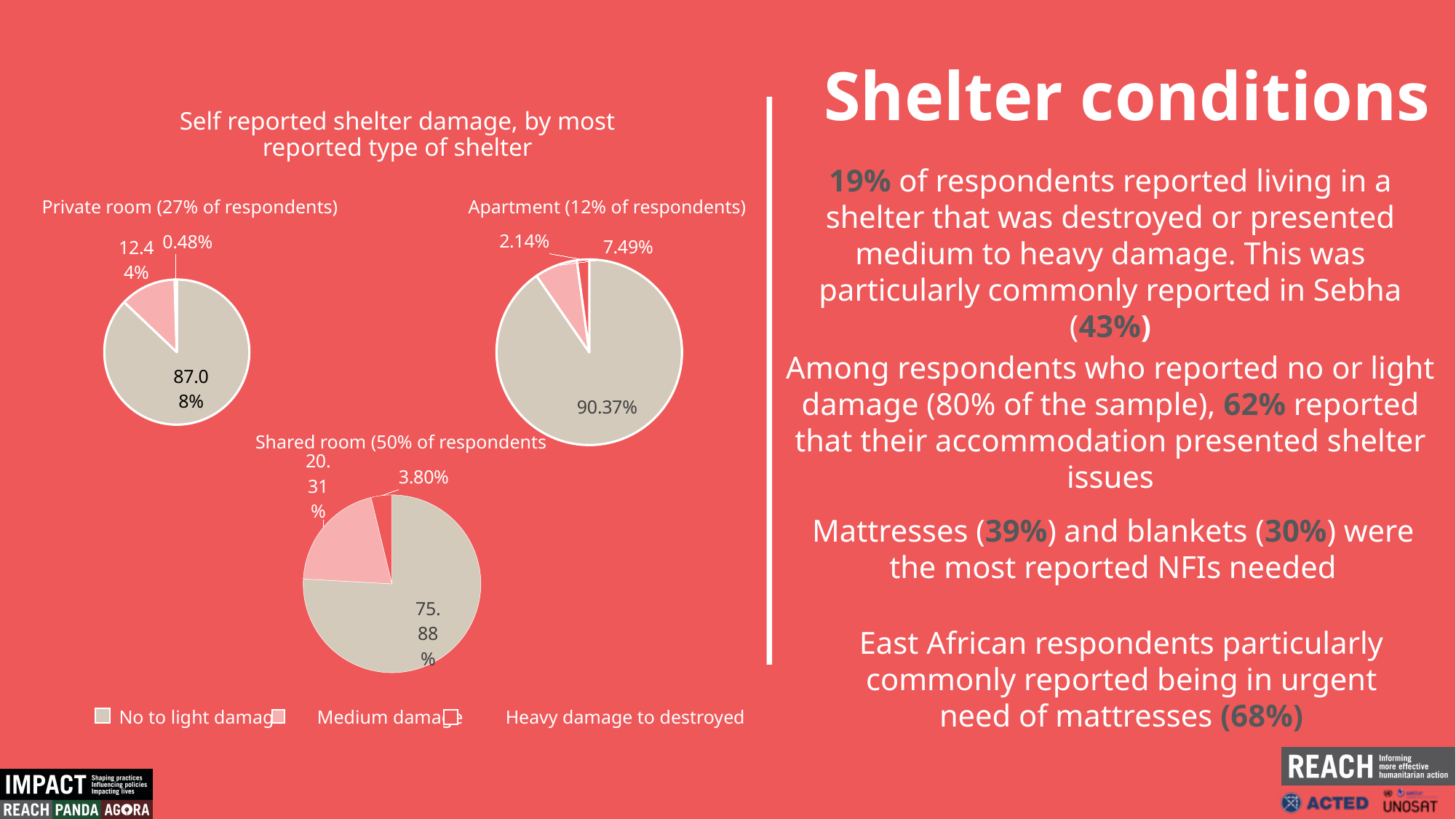
In the Private room pie chart, what share of respondents reported heavy damage to destroyed? 0.48% What kind of charts are shown on the slide? Pie charts What is the difference between the no to light damage share in the Apartment pie chart and in the Shared room pie chart? 14.49% Which shelter type has the larger share of medium damage: Private room or Shared room? Shared room How many categories does the legend list for the pie charts? 3 In the Apartment pie chart, what share of respondents reported heavy damage to destroyed? 2.14% In the Shared room pie chart, which damage category has the largest slice? No to light damage In the Shared room pie chart, what share of respondents reported medium damage? 20.31% How many pie charts are shown on the slide? 3 What is the title of the chart group on the slide? Self reported shelter damage, by most reported type of shelter In the Apartment pie chart, which damage category has the smallest slice? Heavy damage to destroyed In the Apartment pie chart, what share of respondents reported no to light damage? 90.37%